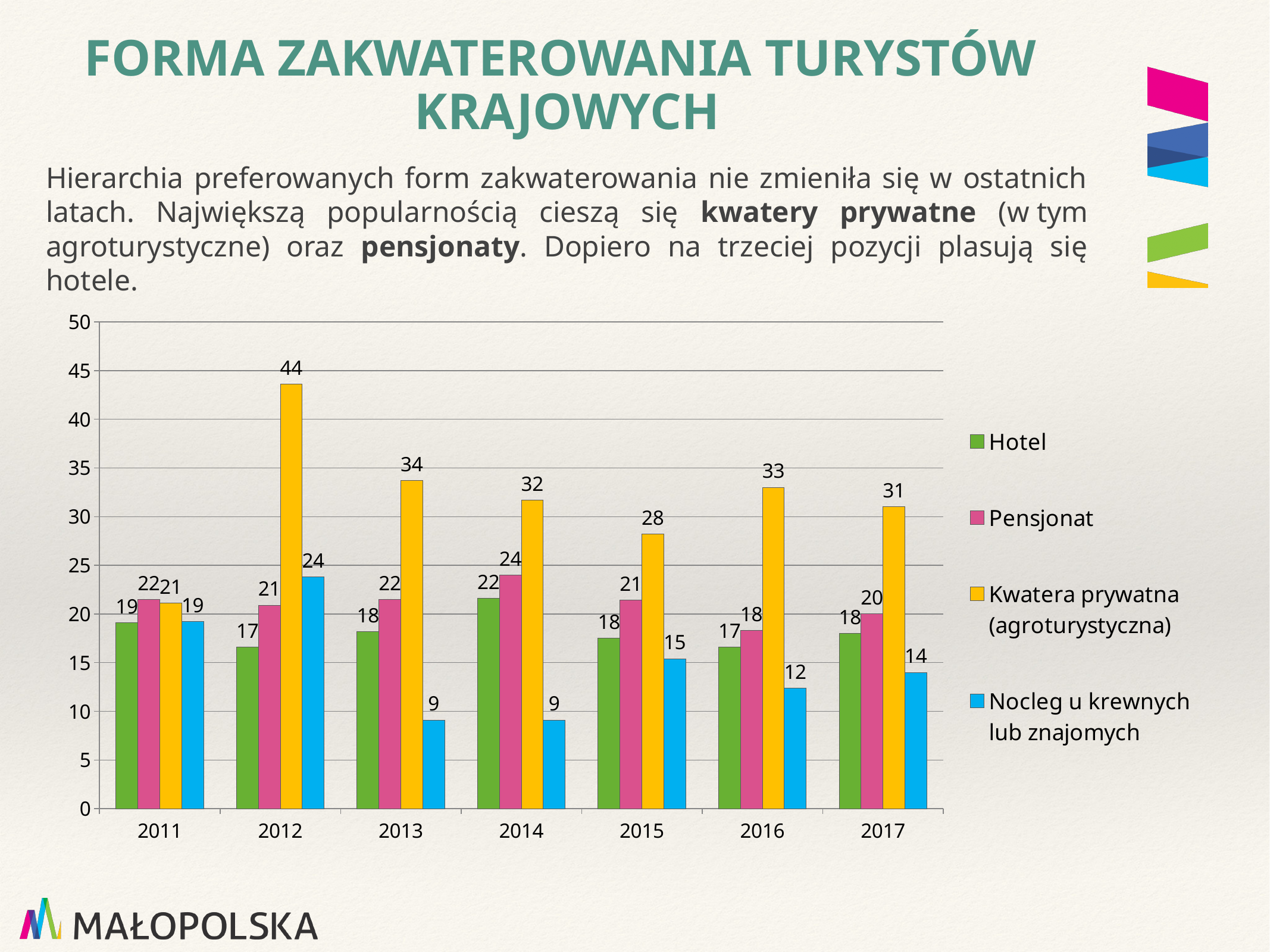
What kind of chart is shown on the slide? Bar chart What is the value for Hotel in 2014? 22 Which colour represents Hotel in the chart? Green What is the value for Kwatera prywatna (agroturystyczna) in 2012? 44 What is the value for Nocleg u krewnych lub znajomych in 2013? 9 What is the value for Pensjonat in 2017? 20 Which is larger in 2015: Pensjonat or Nocleg u krewnych lub znajomych? Pensjonat How many years are shown on the x axis? 7 What is the difference between the Kwatera prywatna (agroturystyczna) value and the Hotel value in 2016? 16 How many series does the legend list? 4 In which year is the value for Kwatera prywatna (agroturystyczna) highest? 2012 In which year is the value for Nocleg u krewnych lub znajomych highest? 2012